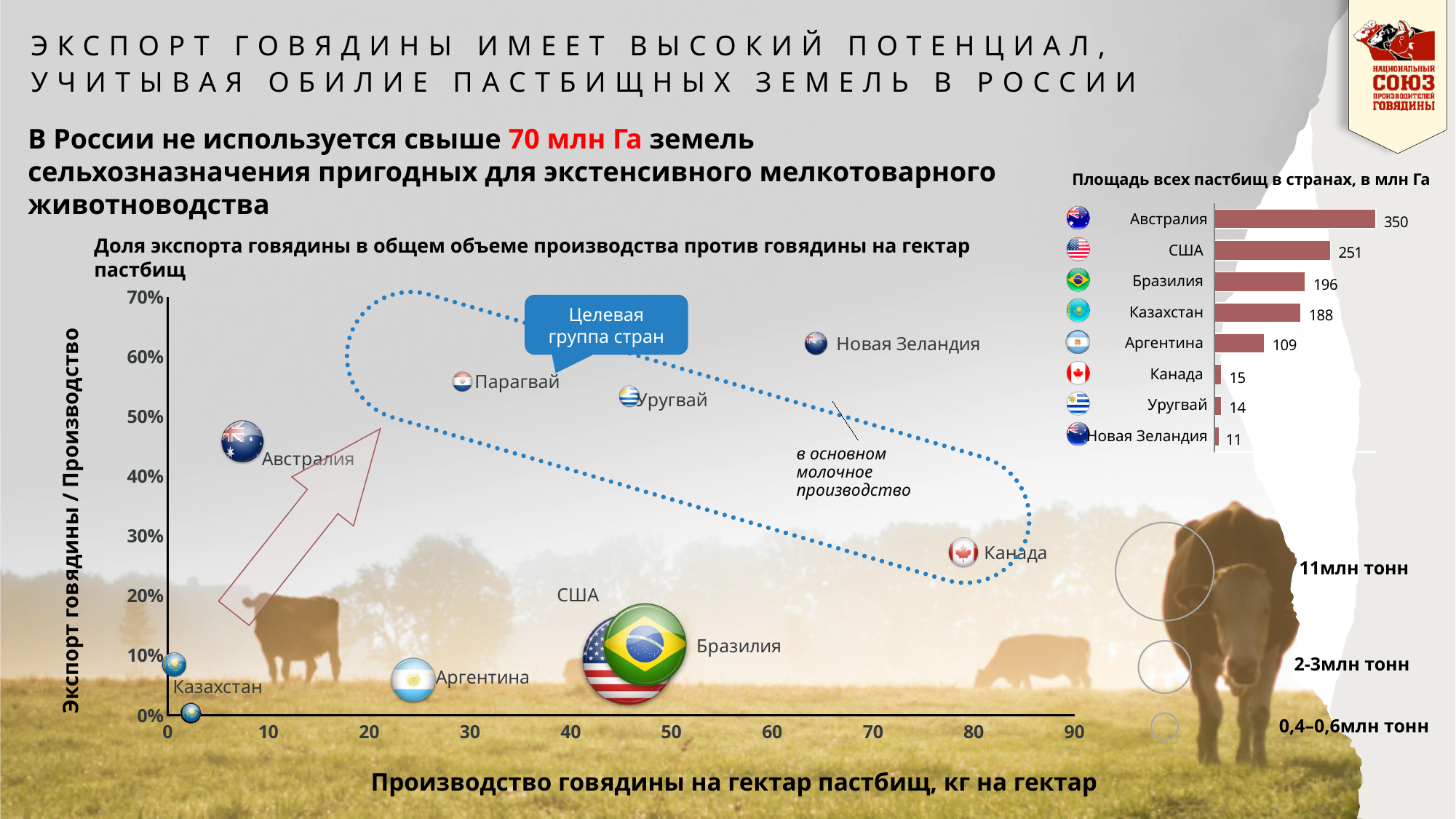
On the bar chart 'Площадь всех пастбищ в странах, в млн Га', what is the value for Уругвай? 14 On the bar chart 'Площадь всех пастбищ в странах, в млн Га', what is the value for Казахстан? 188 On the scatter chart 'Доля экспорта говядины в общем объеме производства против говядины на гектар пастбищ', is the export share for Казахстан greater or less than 10%? less On the bar chart 'Площадь всех пастбищ в странах, в млн Га', which country has the lowest value? Новая Зеландия What kind of chart is 'Площадь всех пастбищ в странах, в млн Га'? bar chart On the bar chart 'Площадь всех пастбищ в странах, в млн Га', what is the difference between the values for США and Бразилия? 55 What is the label of the x axis on the scatter chart 'Доля экспорта говядины в общем объеме производства против говядины на гектар пастбищ'? Производство говядины на гектар пастбищ, кг на гектар On the scatter chart 'Доля экспорта говядины в общем объеме производства против говядины на гектар пастбищ', is the export share for Австралия greater or less than 40%? greater On the bar chart 'Площадь всех пастбищ в странах, в млн Га', which is larger: the value for Аргентина or the value for Канада? Аргентина On the bar chart 'Площадь всех пастбищ в странах, в млн Га', what is the value for Австралия? 350 On the bar chart 'Площадь всех пастбищ в странах, в млн Га', which country has the highest value? Австралия How many countries are shown on the bar chart 'Площадь всех пастбищ в странах, в млн Га'? 8